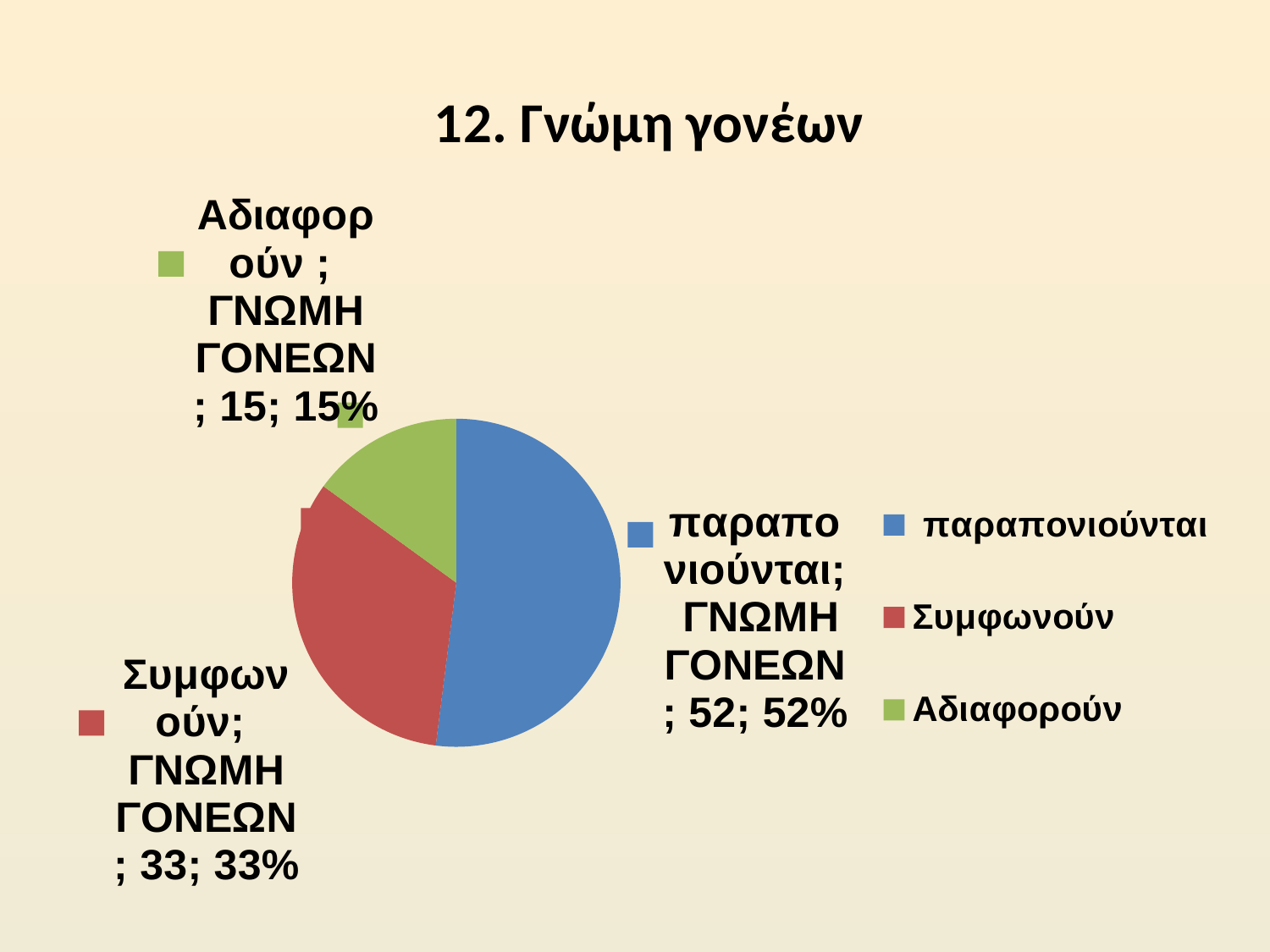
Which is larger, Συμφωνούν or Αδιαφορούν? Συμφωνούν Which category has the largest slice? παραπονιούνται Which category has the smallest slice? Αδιαφορούν What is the value for Συμφωνούν? 33 What is the title of the slide? 12. Γνώμη γονέων What share of the pie does Αδιαφορούν represent? 15% What share of the pie does παραπονιούνται represent? 52% What is the value for παραπονιούνται? 52 What kind of chart is shown on the slide? pie chart What is the value for Αδιαφορούν? 15 What is the difference between the values for παραπονιούνται and Συμφωνούν? 19 How many categories does the pie chart have? 3